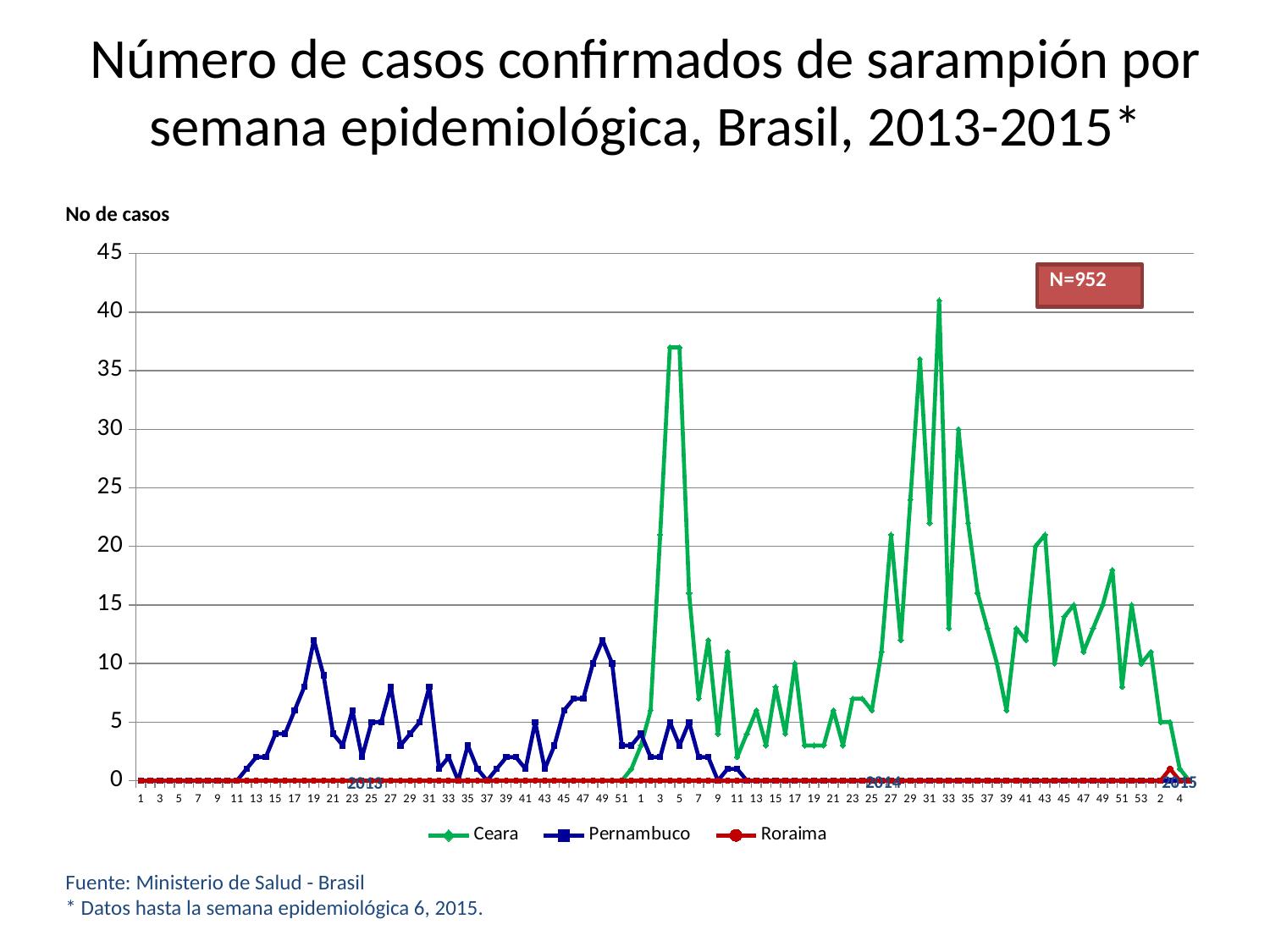
What kind of chart is shown on the slide? line chart How many series does the legend list? 3 How many years are marked along the x axis? 3 Is the highest value for Roraima greater or less than 5? less In which year does Ceara reach its highest value? 2014 Do the Ceara values rise or fall over the last weeks shown in 2015? fall Which series reaches the highest peak on the chart? Ceara Is the highest value for Pernambuco greater or less than 15? less Which series has the higher peak, Pernambuco or Roraima? Pernambuco Is the highest value for Ceara greater or less than 35? greater Which series are listed in the legend? Ceara, Pernambuco, Roraima What total N is shown in the box on the chart? N=952